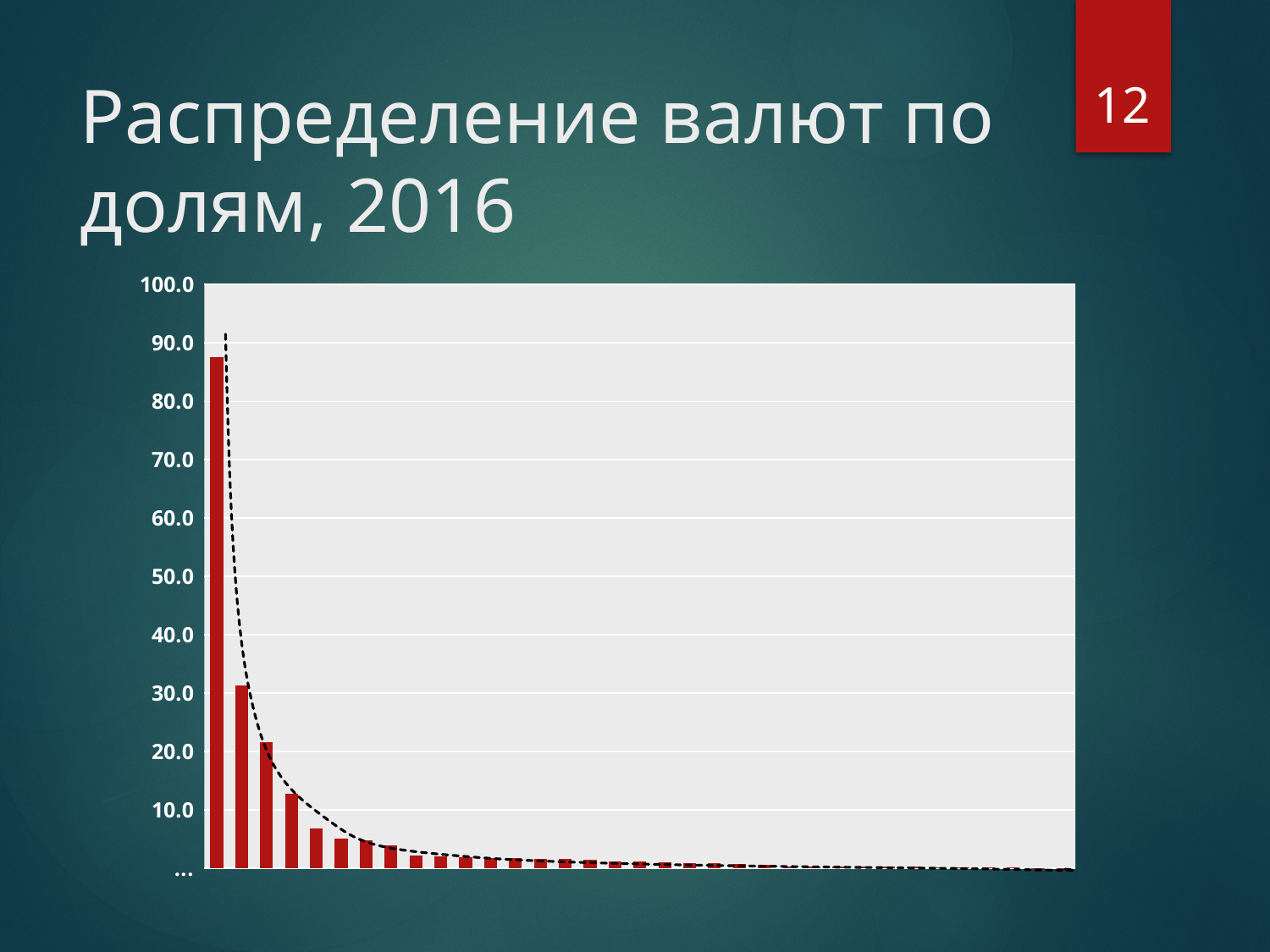
What kind of chart is shown on the slide? bar chart What is the highest value shown on the vertical axis? 100.0 Which is larger, the first bar or the second bar from the left? the first bar What is the title of the slide containing the chart? Распределение валют по долям, 2016 Is the value of the first (leftmost) bar greater or less than 90.0? less Is the value of the fifth bar from the left greater or less than 10.0? less Do the bar values rise or fall from left to right along the x axis? fall Is the value of the third bar from the left greater or less than 30.0? less Which bar is the highest in the chart? the first (leftmost) bar